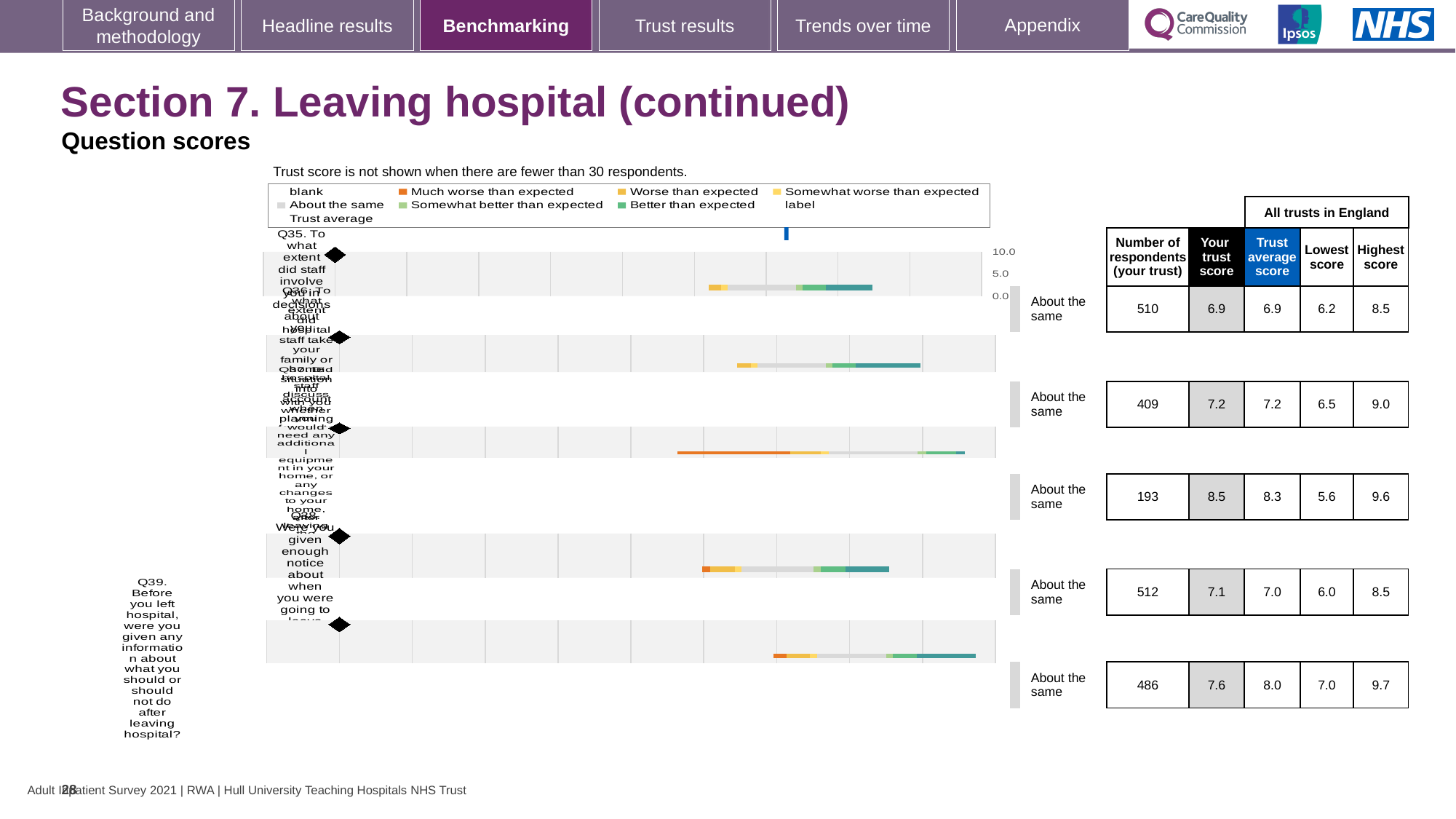
What is the difference between the trust average score and your trust score for Q39? 0.4 How many respondents from your trust answered Q39? 486 What is the trust average score for Q35 (staff involving you in decisions about leaving hospital)? 6.9 What is the highest score across all trusts in England for Q39? 9.7 What benchmark category is shown for Q35? About the same For Q39, which is larger: your trust score or the trust average score? Trust average score What kind of chart is used to show the question scores on this slide? bar chart What is the lowest score across all trusts in England for Q38 (enough notice about when you were going to leave hospital)? 6.0 How many questions are shown in the chart on this slide? 5 What is the 'Your trust score' for Q39 (information about what you should or should not do after leaving hospital)? 7.6 What is the highest 'Your trust score' value shown in the table? 8.5 Is your trust score for Q39 greater or less than 5.0? greater